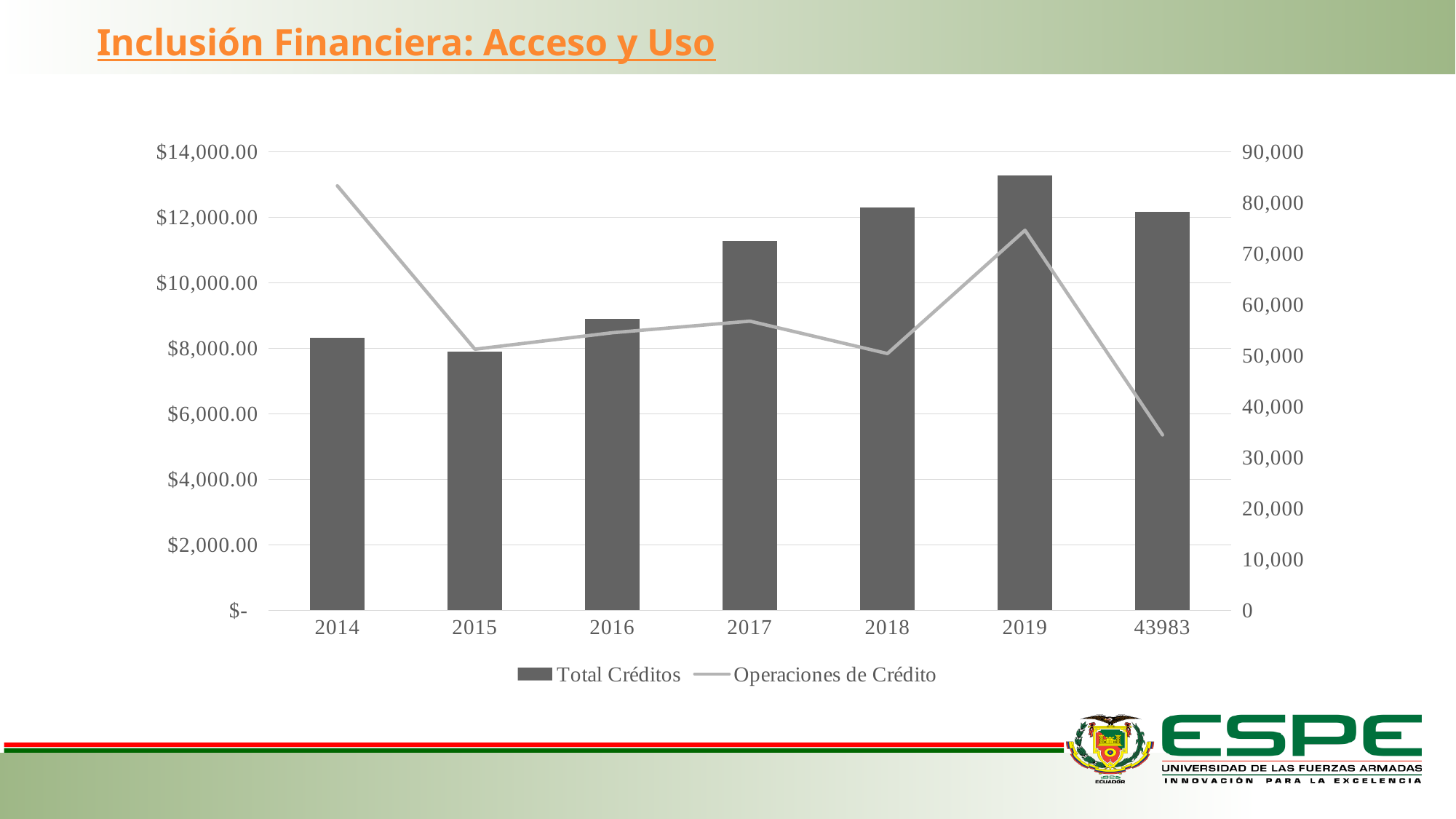
Which year has the lowest Total Créditos bar? 2015 Is the Total Créditos value for 2015 greater or less than $8,000.00? less Which is larger, the Total Créditos bar for 2017 or for 2016? 2017 What kind of chart is shown on the slide? A combined bar and line chart Is the Operaciones de Crédito value for 2014 greater or less than 80,000? greater At which x-axis category is the Operaciones de Crédito line at its lowest point? 43983 Which year has the highest Total Créditos bar? 2019 Is the Total Créditos value for 2018 greater or less than $12,000.00? greater Do the Total Créditos bars generally rise or fall from 2015 to 2019? rise How many series does the legend list? 2 In which year is the Operaciones de Crédito line at its highest point? 2014 How many categories are shown on the x axis? 7